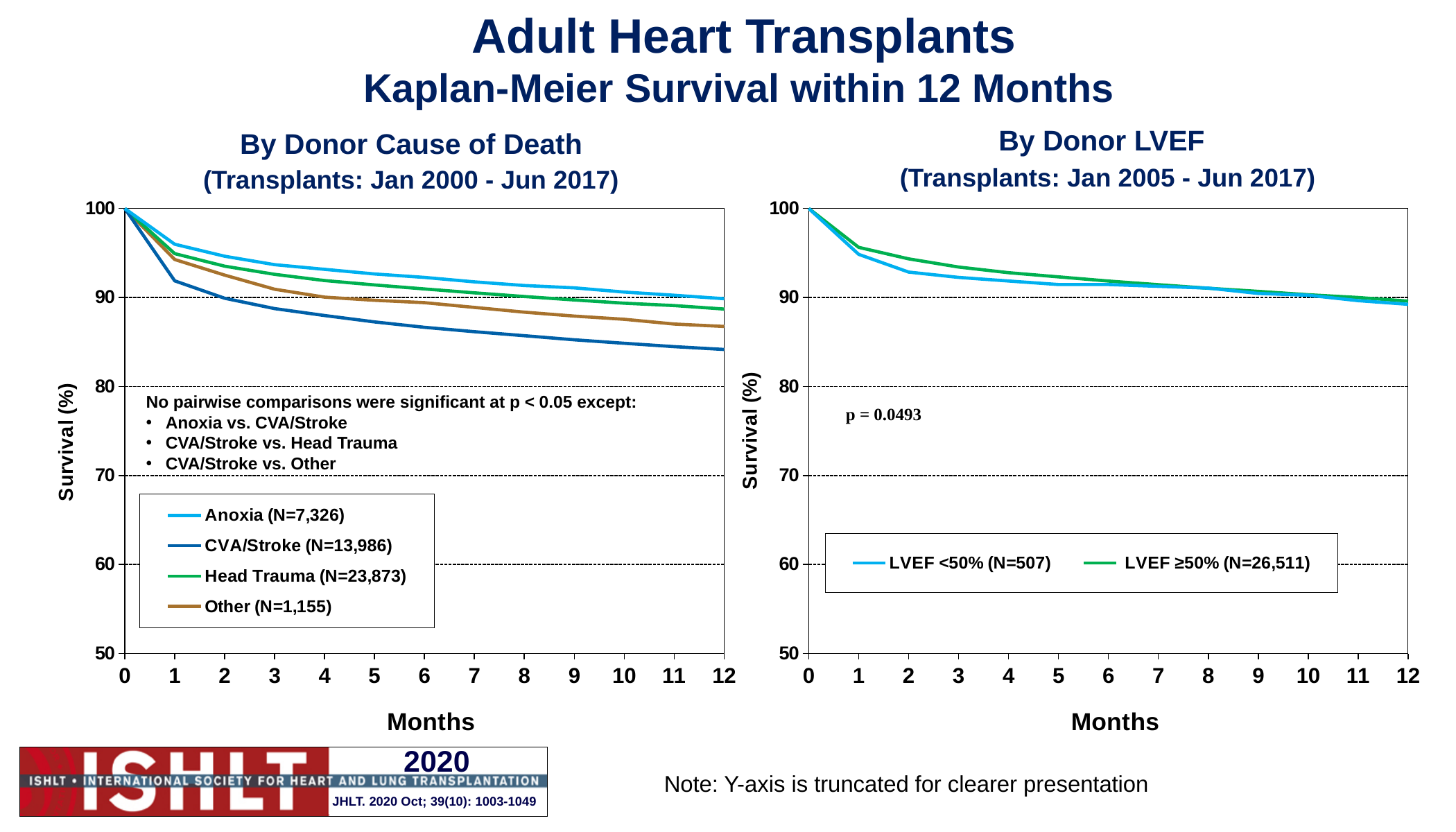
On the 'By Donor LVEF' chart, is the survival for LVEF <50% at 2 months greater or less than 90? greater On the 'By Donor Cause of Death' chart, which series has the lowest survival at 12 months? CVA/Stroke (N=13,986) On the 'By Donor Cause of Death' chart, how many series does the legend list? 4 On the 'By Donor LVEF' chart, what p-value is printed on the chart? p = 0.0493 On the 'By Donor LVEF' chart, at 1 month, which is larger: survival for LVEF <50% or for LVEF ≥50%? LVEF ≥50% On the 'By Donor Cause of Death' chart, which series has the highest survival at 12 months? Anoxia (N=7,326) On the 'By Donor LVEF' chart, how many series does the legend list? 2 On the 'By Donor Cause of Death' chart, is the survival for CVA/Stroke at 12 months greater or less than 90? less On the 'By Donor Cause of Death' chart, what kind of chart is shown? Line chart On the 'By Donor Cause of Death' chart, is the survival for Other at 12 months greater or less than 90? less On the 'By Donor Cause of Death' chart, do the survival curves rise or fall as months increase? Fall On the 'By Donor Cause of Death' chart, at 6 months, which is larger: survival for Head Trauma or for CVA/Stroke? Head Trauma